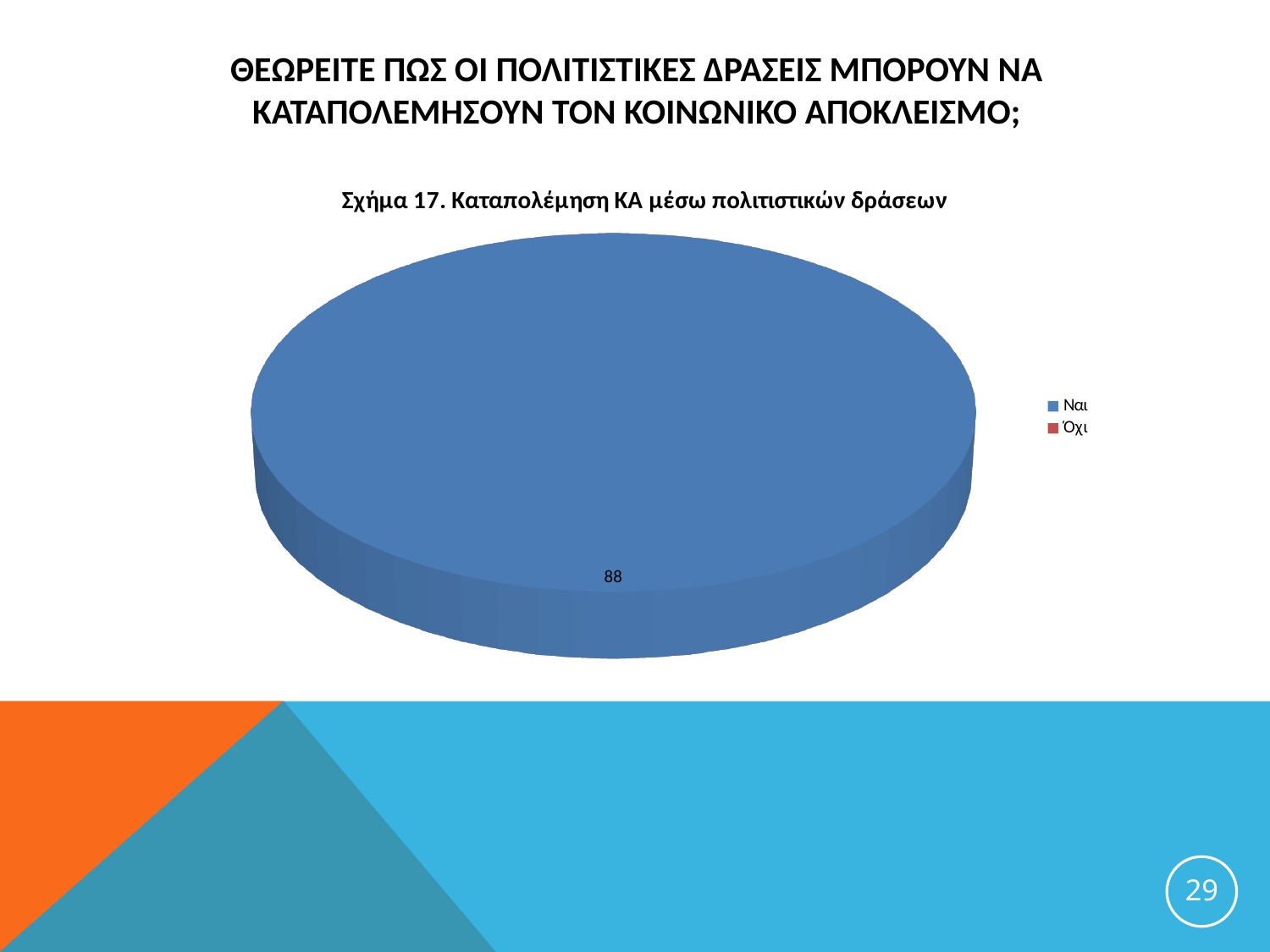
Which is larger in the pie chart, Ναι or Όχι? Ναι What value is shown for the Ναι slice of the pie chart? 88 What is the title of the chart? Σχήμα 17. Καταπολέμηση ΚΑ μέσω πολιτιστικών δράσεων What kind of chart is shown on the slide? pie chart Which category has the smallest share of the pie chart? Όχι Is the value for Ναι greater or less than 50? greater How many categories does the legend of the chart list? 2 What colour represents Ναι in the chart legend? blue Which category takes up the largest share of the pie chart? Ναι